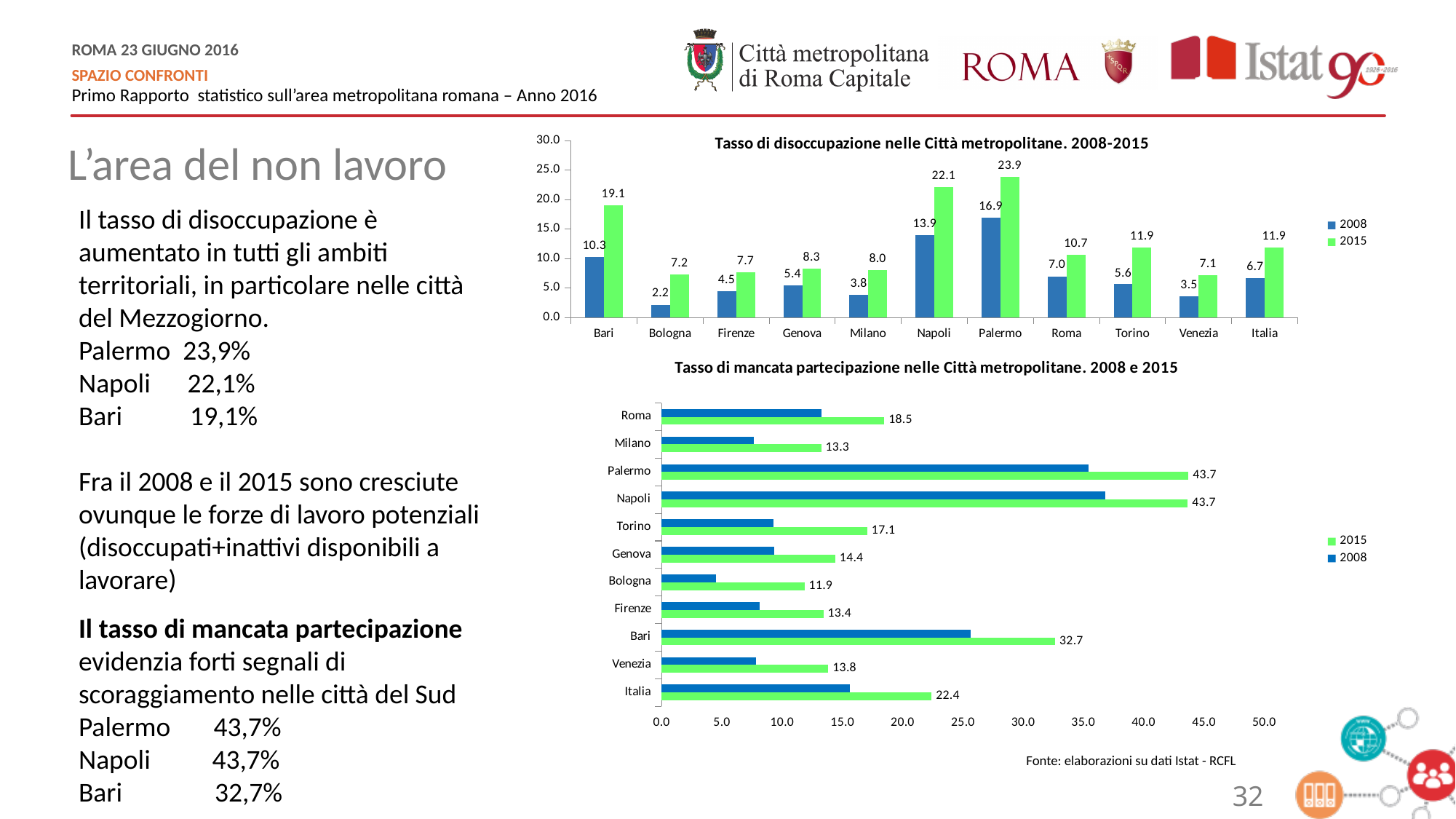
In the chart 'Tasso di disoccupazione nelle Città metropolitane. 2008-2015', how many series does the legend list? 2 In the chart 'Tasso di mancata partecipazione nelle Città metropolitane. 2008 e 2015', is the 2008 value for Palermo greater or less than 30.0? greater In the chart 'Tasso di mancata partecipazione nelle Città metropolitane. 2008 e 2015', what is the 2015 value for Bari? 32.7 In the chart 'Tasso di disoccupazione nelle Città metropolitane. 2008-2015', which city has the highest 2015 value? Palermo In the chart 'Tasso di disoccupazione nelle Città metropolitane. 2008-2015', which city has the lowest 2008 value? Bologna In the chart 'Tasso di mancata partecipazione nelle Città metropolitane. 2008 e 2015', what is the 2015 value for Torino? 17.1 What type of chart is 'Tasso di mancata partecipazione nelle Città metropolitane. 2008 e 2015'? Bar chart In the chart 'Tasso di disoccupazione nelle Città metropolitane. 2008-2015', what is the 2008 value for Bologna? 2.2 In the chart 'Tasso di disoccupazione nelle Città metropolitane. 2008-2015', how many cities/categories are shown on the x axis? 11 In the chart 'Tasso di mancata partecipazione nelle Città metropolitane. 2008 e 2015', which has the larger 2015 value, Roma or Milano? Roma In the chart 'Tasso di disoccupazione nelle Città metropolitane. 2008-2015', what is the 2015 value for Napoli? 22.1 In the chart 'Tasso di disoccupazione nelle Città metropolitane. 2008-2015', what is the difference between the 2015 and 2008 values for Bari? 8.8